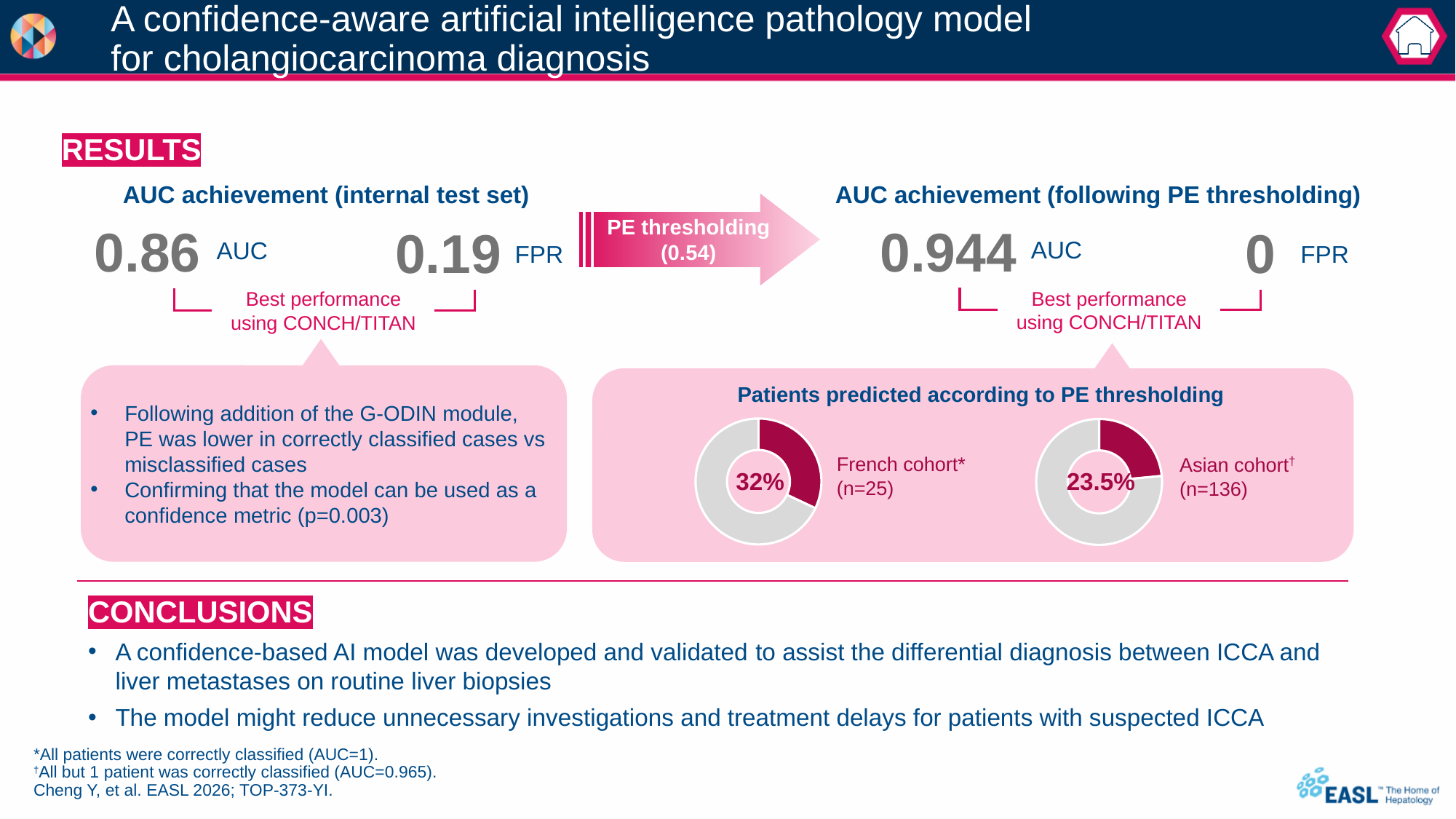
What is the sample size (n) shown next to the Asian cohort donut chart? n=136 In the 'Patients predicted according to PE thresholding' charts, which cohort has the lowest percentage? Asian cohort What kind of chart is used to show the patients predicted according to PE thresholding? Donut (pie) chart In the 'Patients predicted according to PE thresholding' charts, what is the difference in percentage points between the French cohort and the Asian cohort? 8.5 In the 'Patients predicted according to PE thresholding' charts, what percentage is shown for the Asian cohort? 23.5% In the 'Patients predicted according to PE thresholding' charts, what percentage is shown for the French cohort? 32% In the 'Patients predicted according to PE thresholding' charts, which cohort has the higher percentage, French or Asian? French cohort What is the sample size (n) shown next to the French cohort donut chart? n=25 How many donut charts are shown under 'Patients predicted according to PE thresholding'? 2 In the French cohort donut chart, what share of the ring is highlighted in dark red? 32% In the Asian cohort donut chart, what share of the ring is highlighted in dark red? 23.5%